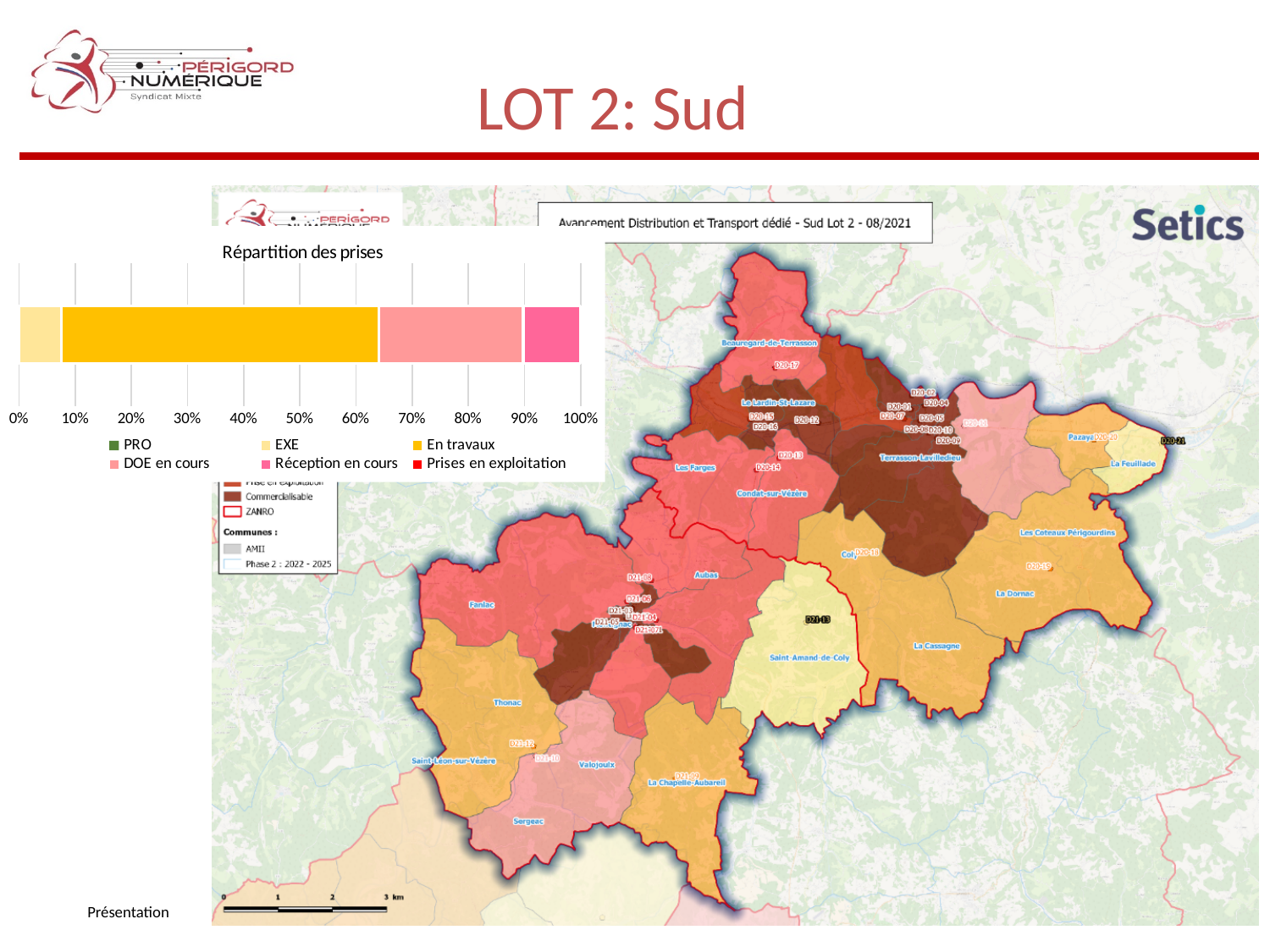
How many coloured segments are visible in the bar of the "Répartition des prises" chart? 4 What is the highest value shown on the x axis of the "Répartition des prises" chart? 100% What is the title of the bar chart on the left of the slide? Répartition des prises In the "Répartition des prises" chart, is the share for Réception en cours greater or less than 20%? less In the "Répartition des prises" chart, which segment is larger: DOE en cours or Réception en cours? DOE en cours In the "Répartition des prises" chart, which series occupies the largest share of the bar? En travaux In the "Répartition des prises" chart, is the share for EXE greater or less than 20%? less How many series does the legend of the "Répartition des prises" chart list? 6 In the "Répartition des prises" chart, which segment is larger: En travaux or DOE en cours? En travaux What kind of chart is "Répartition des prises"? bar chart In the "Répartition des prises" chart, is the share for DOE en cours greater or less than 20%? greater